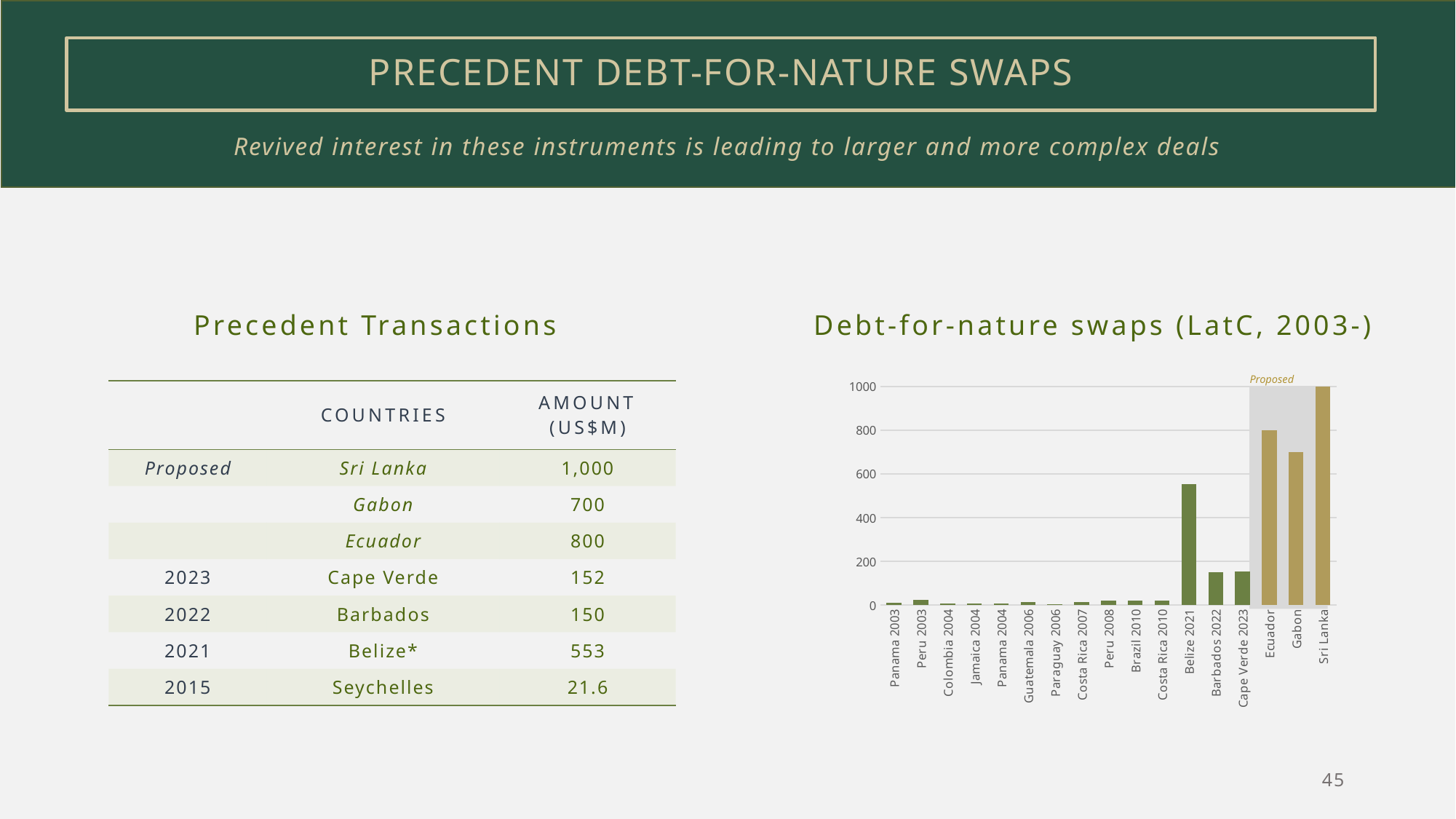
What kind of chart is shown under the title "Debt-for-nature swaps (LatC, 2003-)"? bar chart In the "Debt-for-nature swaps (LatC, 2003-)" chart, do the bar values generally rise or fall from left to right along the x axis? rise In the "Debt-for-nature swaps (LatC, 2003-)" chart, which category has the highest bar? Sri Lanka In the "Debt-for-nature swaps (LatC, 2003-)" chart, is the value for Barbados 2022 greater or less than 200? less In the "Debt-for-nature swaps (LatC, 2003-)" chart, is the value for Belize 2021 greater or less than 400? greater In the "Debt-for-nature swaps (LatC, 2003-)" chart, what value does the Sri Lanka bar reach on the y axis? 1000 In the "Debt-for-nature swaps (LatC, 2003-)" chart, which is larger, the bar for Ecuador or the bar for Gabon? Ecuador In the "Debt-for-nature swaps (LatC, 2003-)" chart, which is larger, the bar for Belize 2021 or the bar for Cape Verde 2023? Belize 2021 In the "Debt-for-nature swaps (LatC, 2003-)" chart, is the value for Gabon greater or less than 600? greater In the "Debt-for-nature swaps (LatC, 2003-)" chart, what value does the Ecuador bar reach on the y axis? 800 In the "Debt-for-nature swaps (LatC, 2003-)" chart, what label appears above the shaded area containing the Ecuador, Gabon and Sri Lanka bars? Proposed In the "Debt-for-nature swaps (LatC, 2003-)" chart, how many categories are shown on the x axis? 17